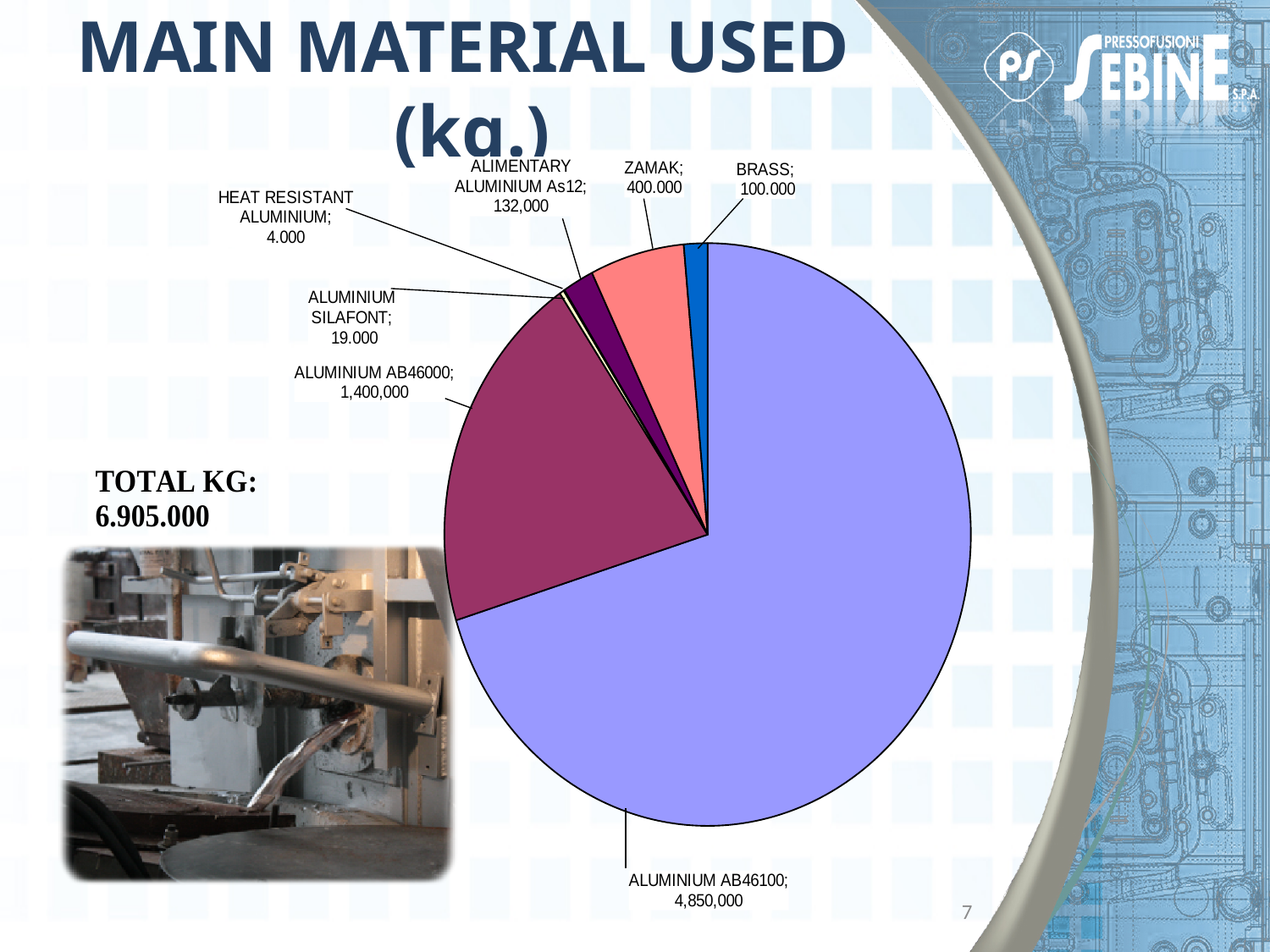
Which is larger, the value for ZAMAK or the value for BRASS? ZAMAK Which material has the largest slice of the pie? ALUMINIUM AB46100 What is the difference between the values for ALUMINIUM AB46100 and ALUMINIUM AB46000? 3,450,000 What kind of chart is shown on the slide? pie chart What is the value for ALIMENTARY ALUMINIUM As12? 132,000 What is the value for ALUMINIUM AB46000? 1,400,000 What is the value for HEAT RESISTANT ALUMINIUM? 4.000 What is the value for ZAMAK? 400.000 Which material has the smallest slice of the pie? HEAT RESISTANT ALUMINIUM What is the title of the chart? MAIN MATERIAL USED (kg.) How many slices does the pie chart have? 7 What is the value for ALUMINIUM AB46100? 4,850,000